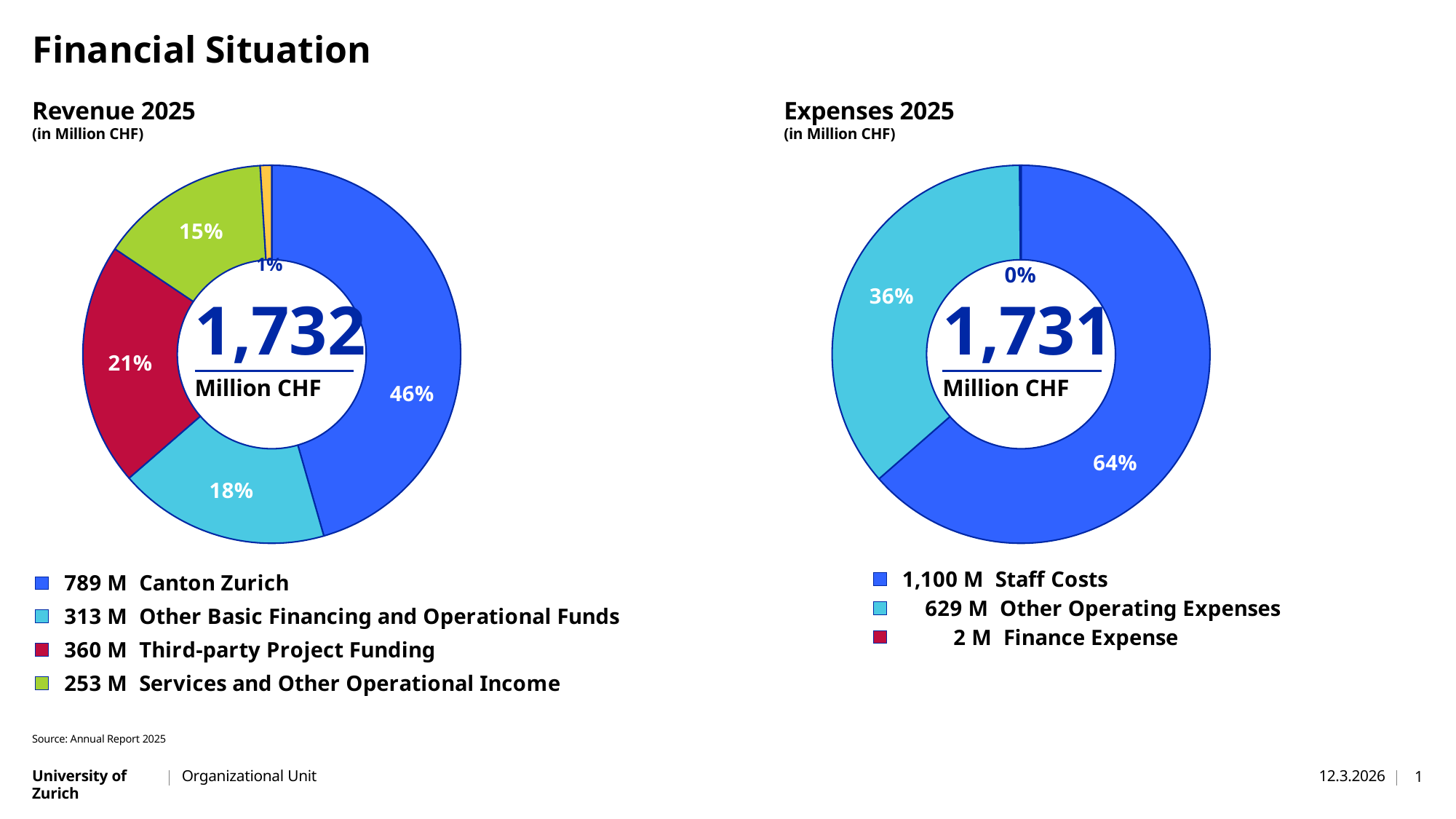
In the Expenses 2025 chart, how many categories does the legend list? 3 In the Expenses 2025 chart, which is larger: Staff Costs or Other Operating Expenses? Staff Costs In the Revenue 2025 chart, which of the four legend categories has the smallest value? Services and Other Operational Income In the Revenue 2025 chart, which category is the largest? Canton Zurich In the Revenue 2025 chart, what is the value for Canton Zurich? 789 M In the Revenue 2025 chart, what is the difference between Third-party Project Funding and Other Basic Financing and Operational Funds? 47 M In the Expenses 2025 chart, what percentage share do Staff Costs have? 64% In the Expenses 2025 chart, what is the value for Other Operating Expenses? 629 M In the Revenue 2025 chart, what total is shown in the centre of the donut? 1,732 Million CHF In the Revenue 2025 chart, what percentage share does Third-party Project Funding have? 21% In the Expenses 2025 chart, what is the difference between Staff Costs and Other Operating Expenses? 471 M What type of chart is used for Revenue 2025? Donut (pie) chart